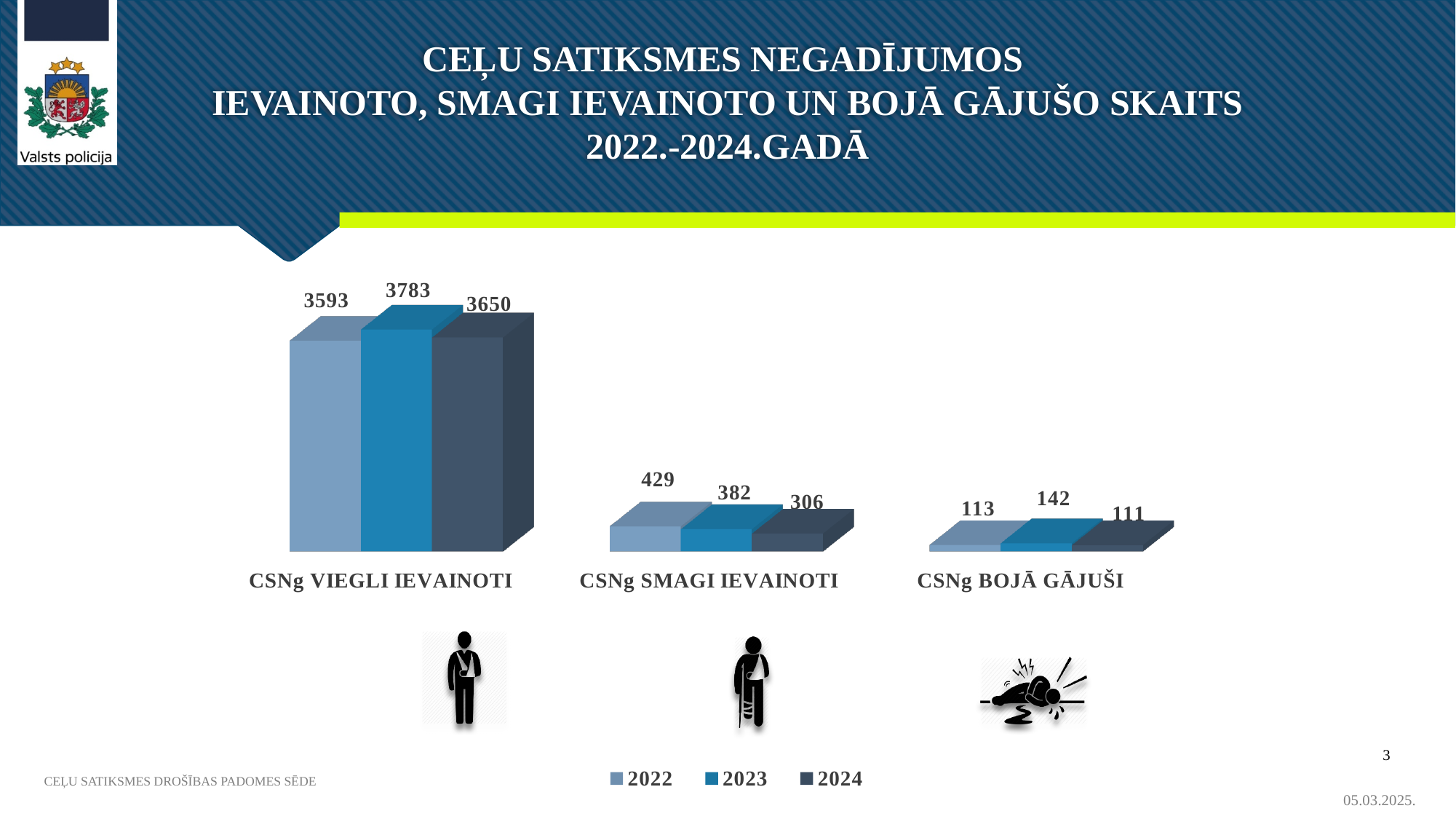
What is the value for 2023 in the CSNg VIEGLI IEVAINOTI category? 3783 Do the values for CSNg SMAGI IEVAINOTI rise or fall from 2022 to 2024? fall What is the difference between the 2022 and 2024 values for CSNg SMAGI IEVAINOTI? 123 How many categories are shown on the x axis? 3 What is the difference between the 2023 and 2022 values for CSNg VIEGLI IEVAINOTI? 190 How many series does the legend list? 3 What kind of chart is shown on the slide? bar chart What is the value for 2022 in the CSNg BOJĀ GĀJUŠI category? 113 Which is larger: the 2022 value or the 2024 value for CSNg VIEGLI IEVAINOTI? 2024 What is the value for 2024 in the CSNg SMAGI IEVAINOTI category? 306 Which year has the highest value in the CSNg BOJĀ GĀJUŠI category? 2023 Which year has the lowest value in the CSNg SMAGI IEVAINOTI category? 2024